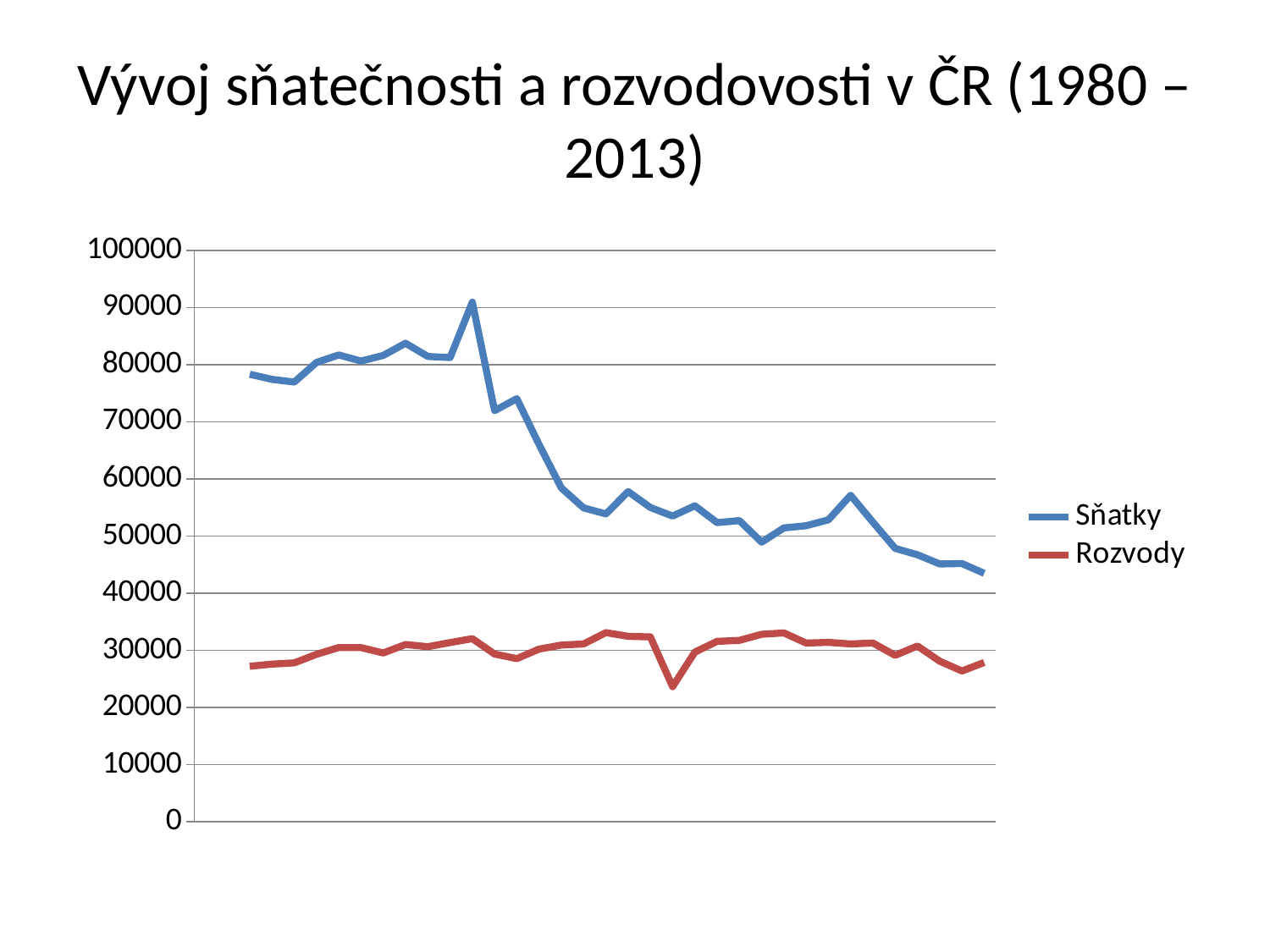
Is the last point of the Sňatky series greater or less than 50000? less Is the first point of the Sňatky series greater or less than 70000? greater How many series does the legend list? 2 Which series has higher values throughout the chart, Sňatky or Rozvody? Sňatky What kind of chart is shown on the slide? line chart Is the lowest point of the Rozvody series greater or less than 30000? less What is the title of the slide? Vývoj sňatečnosti a rozvodovosti v ČR (1980 – 2013) Does the Sňatky series overall rise or fall from left to right? fall Which series contains the lowest point plotted on the chart? Rozvody What are the two series named in the legend? Sňatky and Rozvody